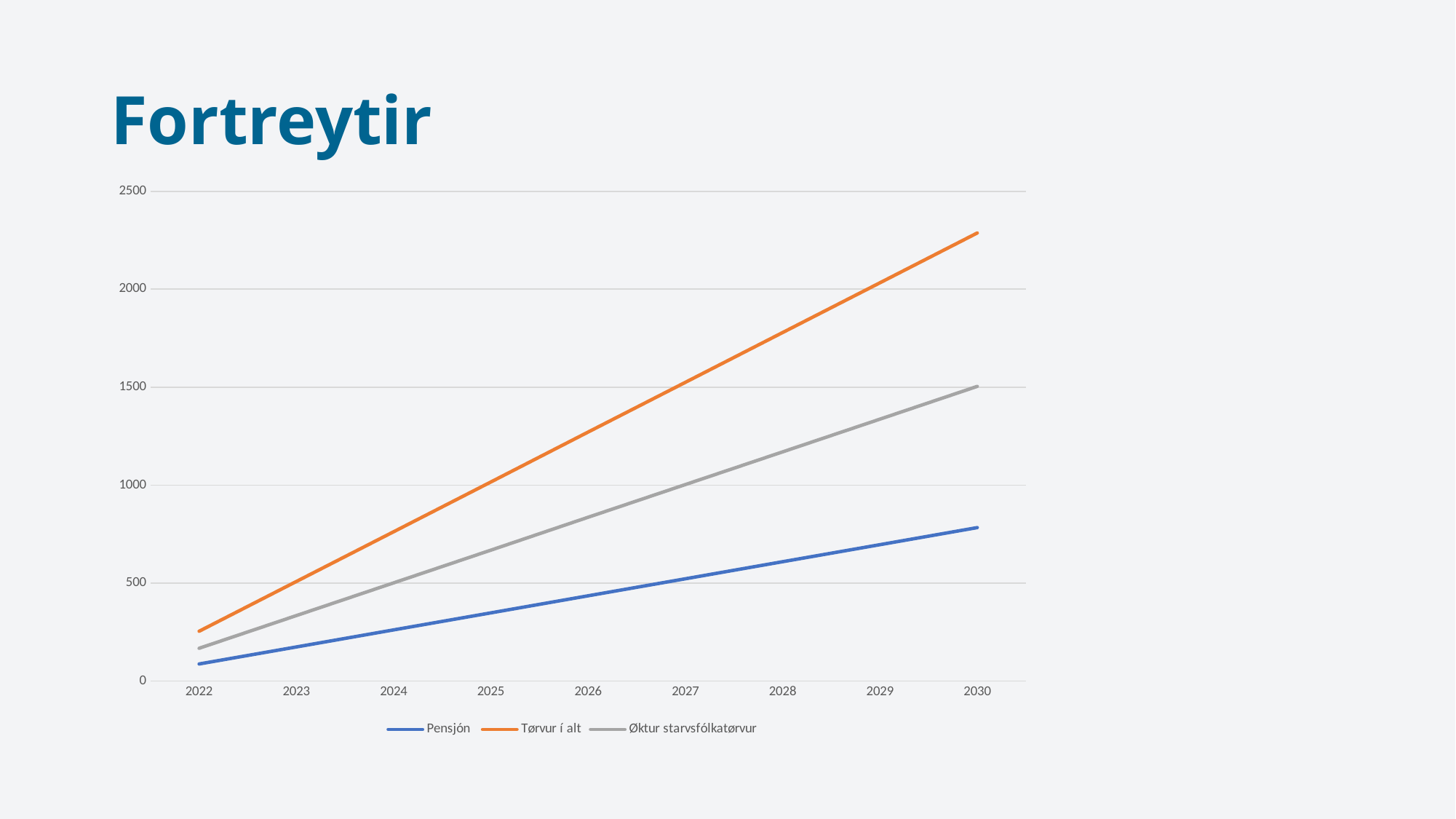
Is the value for Tørvur í alt in 2026 greater or less than 1000? greater What kind of chart is shown on the slide? Line chart In 2028, which is larger: Øktur starvsfólkatørvur or Pensjón? Øktur starvsfólkatørvur Which series has the highest value in 2030? Tørvur í alt What is the title of the slide? Fortreytir Do the values for Tørvur í alt rise or fall from 2022 to 2030? Rise Is the value for Øktur starvsfólkatørvur in 2022 greater or less than 500? less Is the value for Tørvur í alt in 2030 greater or less than 2000? greater How many years are shown on the x axis? 9 Which series has the lowest value in 2030? Pensjón How many series does the legend list? 3